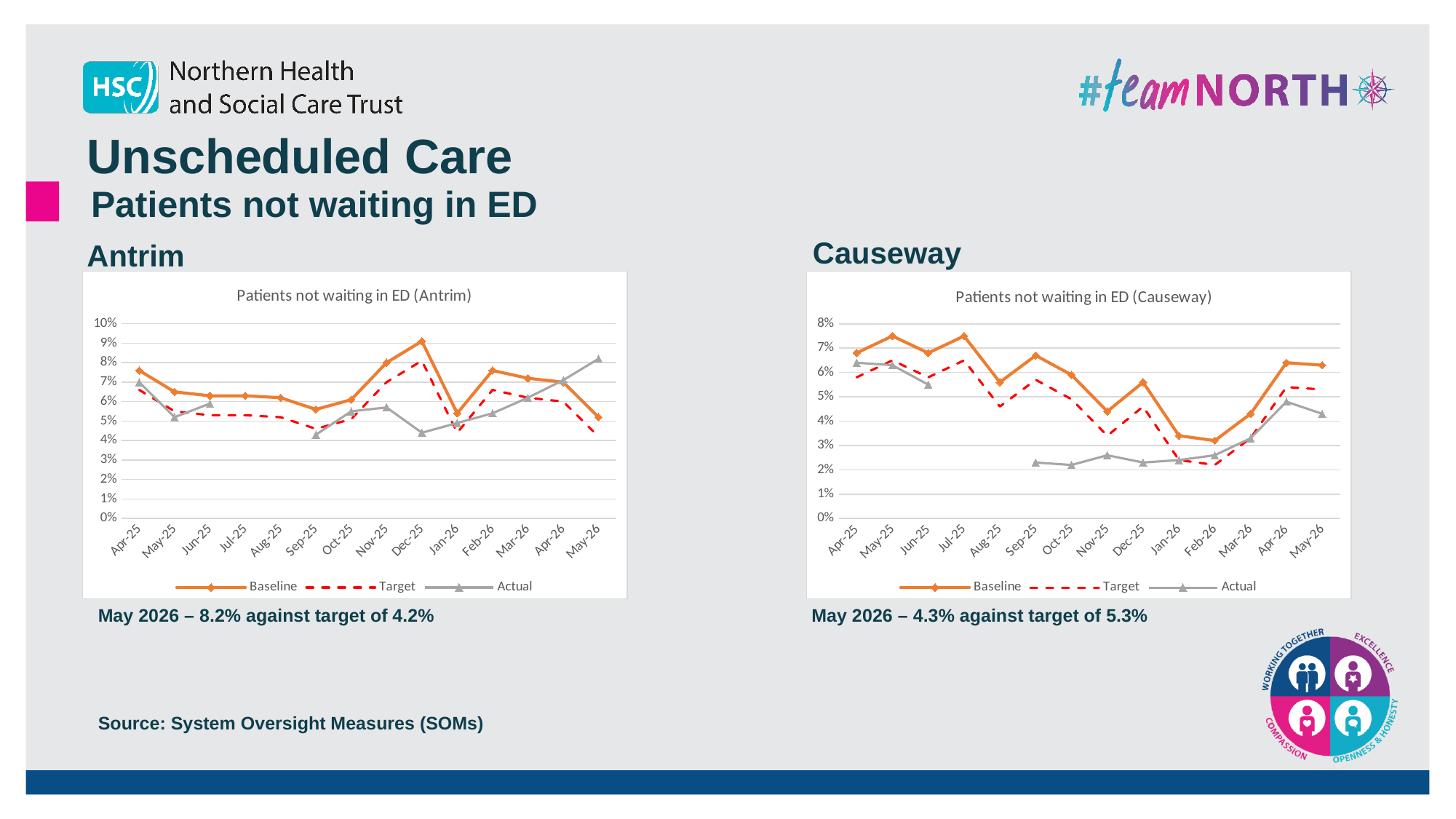
In the Causeway chart, what is the Target value for May 2026? 5.3% In the Antrim chart, in which month is the Baseline series highest? Dec-25 Which series in the Causeway chart is drawn as a red dashed line? Target In the Antrim chart, by how much does the May 2026 Actual value exceed the target? 4.0 percentage points What kind of chart is the Antrim chart, 'Patients not waiting in ED (Antrim)'? Line chart How many series does the legend of the Causeway chart list? 3 In the Antrim chart, is the Actual value for Sep-25 greater or less than 5%? less How many months are shown on the x axis of the Antrim chart? 14 In the Causeway chart, is the Actual value for Oct-25 greater or less than 3%? less In the Causeway chart, which is larger for May 2026, the Actual value or the Target value? Target In the Antrim chart, what is the Actual value for May 2026? 8.2% In the Antrim chart, is the Baseline value for Dec-25 greater or less than 8%? greater